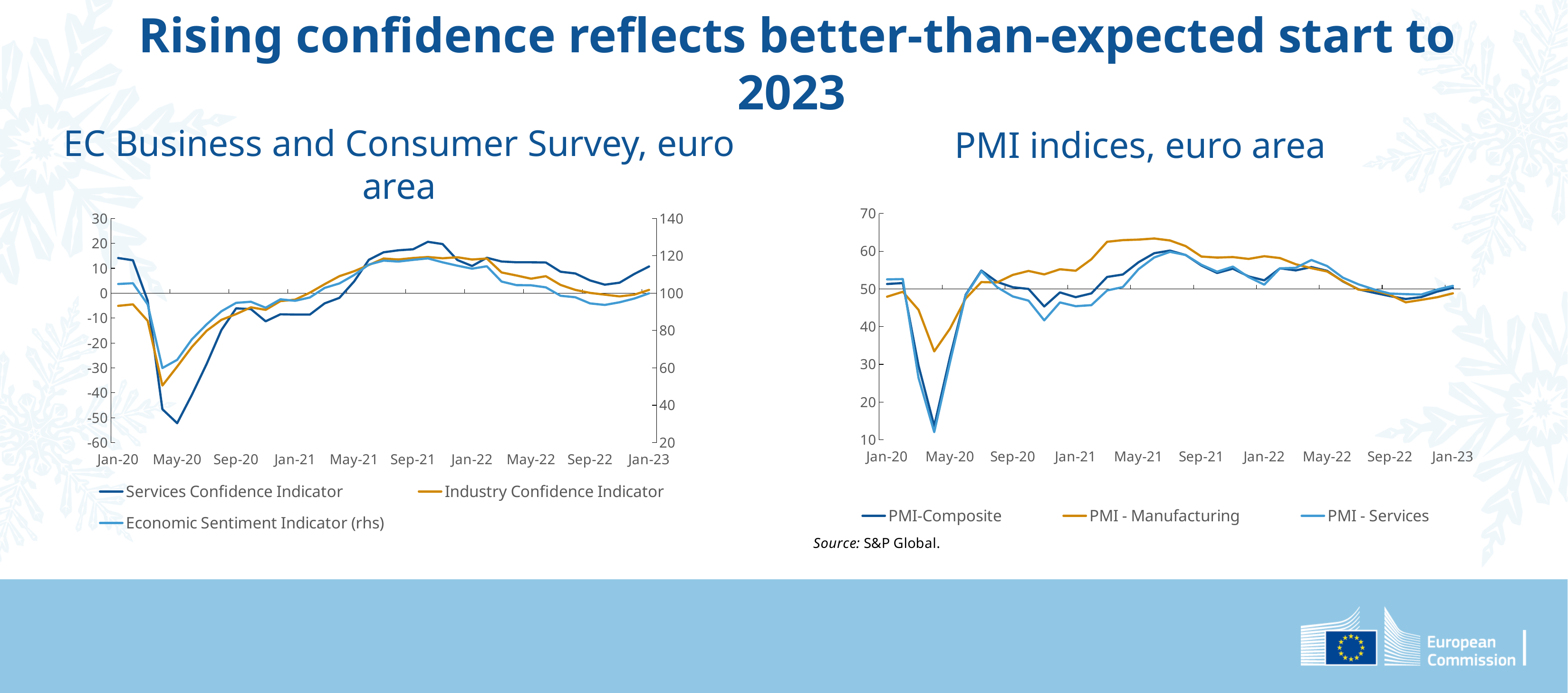
What kind of chart is the 'PMI indices, euro area' chart? Line chart How many date labels are shown on the x axis of the 'PMI indices, euro area' chart? 10 In the 'PMI indices, euro area' chart, is the lowest value of PMI-Composite in 2020 greater or less than 20? less How many series does the legend of the 'EC Business and Consumer Survey, euro area' chart list? 3 In the 'EC Business and Consumer Survey, euro area' chart, does the Services Confidence Indicator rise or fall between Jan-20 and May-20? Fall Which series in the 'EC Business and Consumer Survey, euro area' chart is plotted on the right-hand axis? Economic Sentiment Indicator (rhs) In the 'PMI indices, euro area' chart, does PMI-Composite rise or fall between Sep-22 and Jan-23? Rise In the 'EC Business and Consumer Survey, euro area' chart, is the lowest value of the Services Confidence Indicator in 2020 greater or less than -40? less How many series does the legend of the 'PMI indices, euro area' chart list? 3 In the 'PMI indices, euro area' chart, is the lowest value of PMI - Manufacturing in 2020 greater or less than 40? less In the 'PMI indices, euro area' chart, which series fell the least during the spring 2020 trough? PMI - Manufacturing